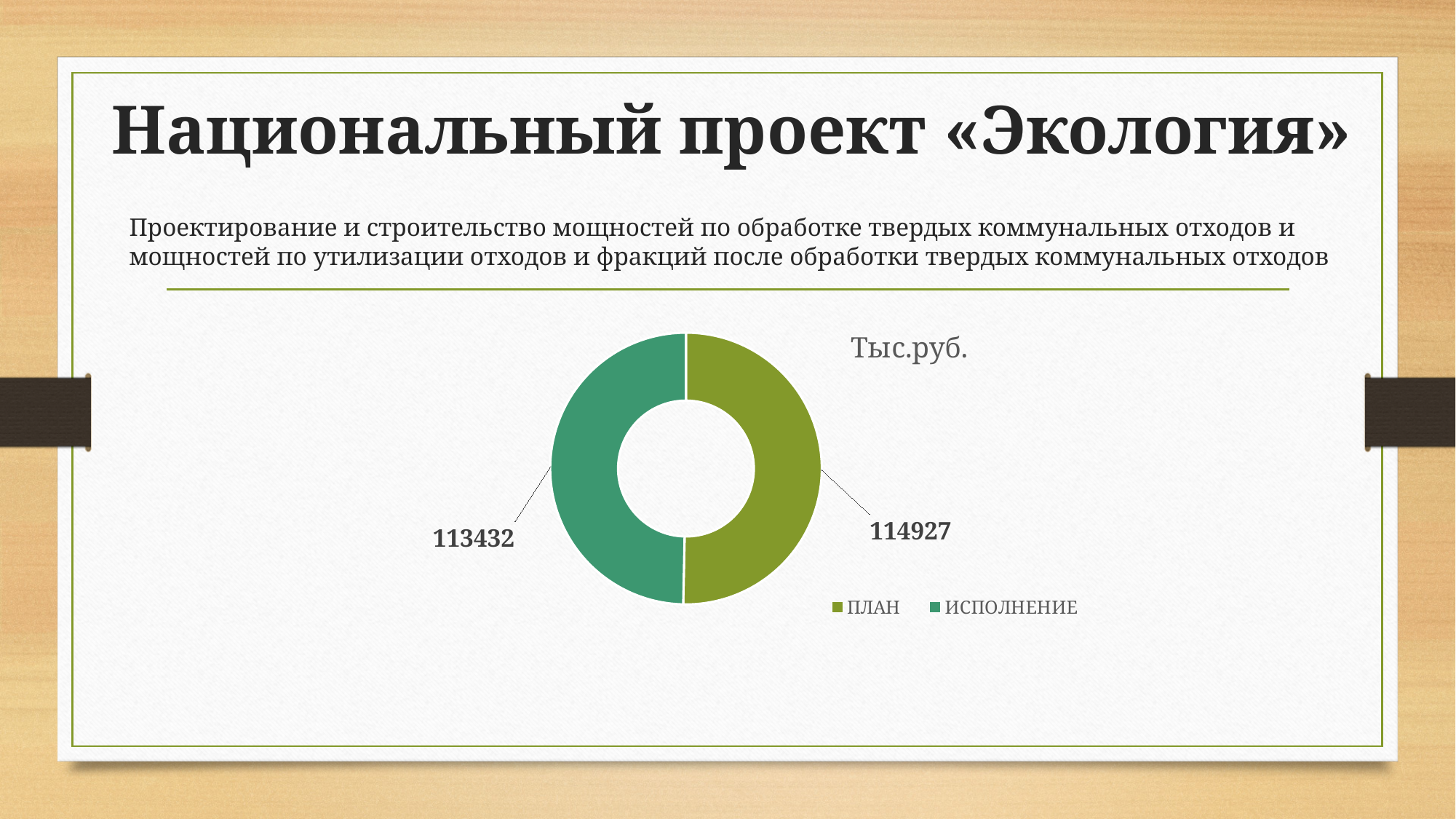
How many entries does the chart legend list? 2 Which category has the highest value on the chart? ПЛАН What is the title of the chart? Тыс.руб. How many categories are shown on the chart? 2 What is the value for ПЛАН on the chart? 114927 Which category has the lowest value on the chart? ИСПОЛНЕНИЕ Which is larger, the value for ПЛАН or the value for ИСПОЛНЕНИЕ? ПЛАН Which legend entry is shown in the darker teal-green colour? ИСПОЛНЕНИЕ What kind of chart is shown on the slide? doughnut chart What is the value for ИСПОЛНЕНИЕ on the chart? 113432 What is the difference between the values for ПЛАН and ИСПОЛНЕНИЕ? 1495